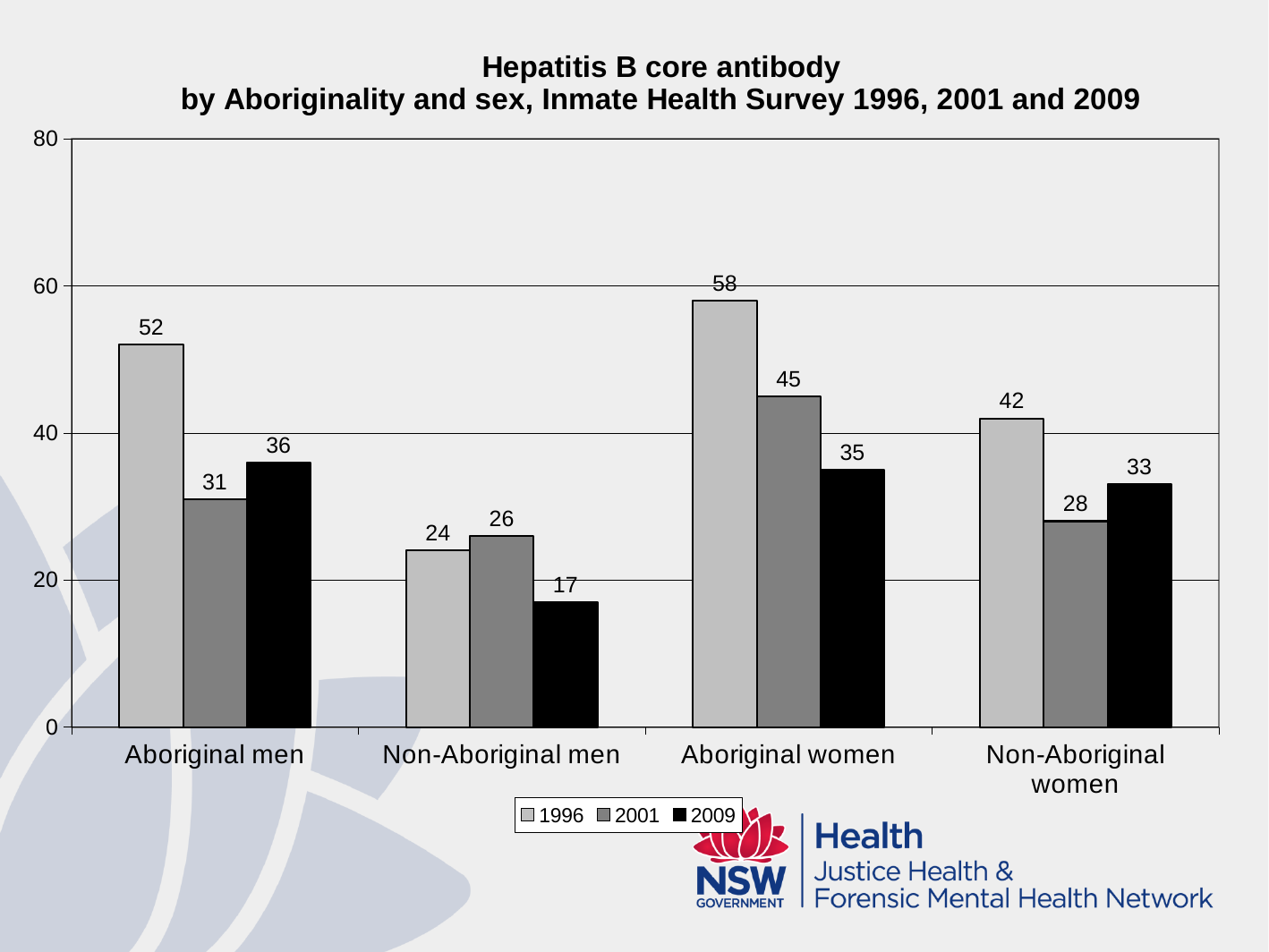
What is the 2009 value for Non-Aboriginal men? 17 How many categories are shown on the x axis? 4 Which category has the lowest 2009 value? Non-Aboriginal men Which is larger for Non-Aboriginal men: the 1996 value or the 2001 value? 2001 What is the 2009 value for Non-Aboriginal women? 33 What kind of chart is shown on the slide? Bar chart Which category has the highest 1996 value? Aboriginal women How many series does the legend list? 3 Is the 1996 value for Non-Aboriginal women greater or less than 40? greater What is the 2001 value for Aboriginal women? 45 What is the 1996 value for Aboriginal men? 52 What is the difference between the 1996 and 2009 values for Aboriginal women? 23